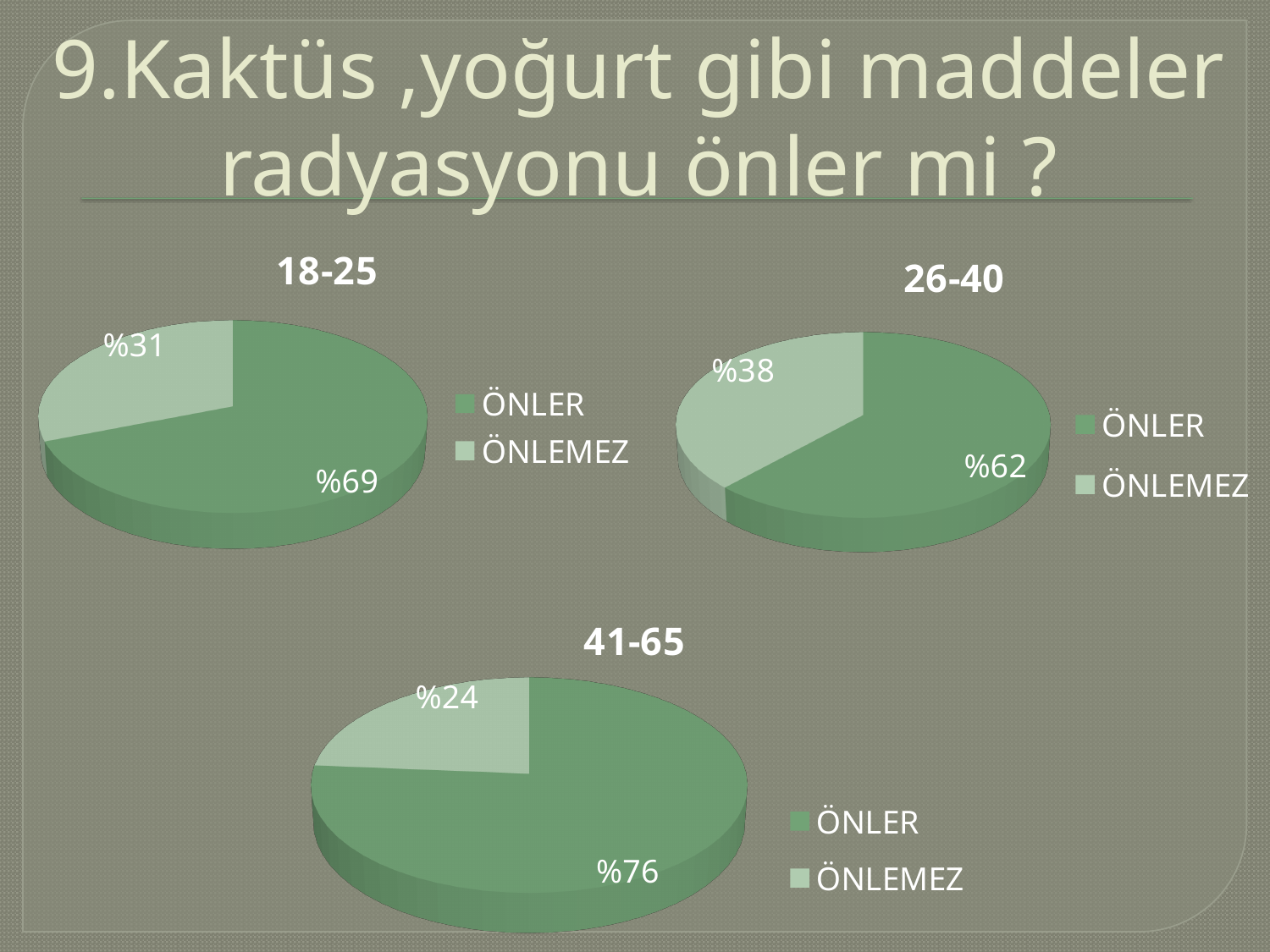
How many entries does the legend of the "18-25" chart list? 2 In the "41-65" pie chart, what is the value for ÖNLER? %76 In the "26-40" pie chart, what is the value for ÖNLER? %62 Which is larger: the ÖNLEMEZ value in the "26-40" chart or the ÖNLEMEZ value in the "41-65" chart? 26-40 In the "18-25" pie chart, what is the difference between the ÖNLER and ÖNLEMEZ values? %38 What kind of chart is the "41-65" chart? Pie chart In the "41-65" pie chart, which slice is the smallest? ÖNLEMEZ In the "41-65" pie chart, what is the value for ÖNLEMEZ? %24 In the "18-25" pie chart, what is the value for ÖNLEMEZ? %31 In the "26-40" pie chart, which slice is the largest? ÖNLER In the "26-40" pie chart, what is the value for ÖNLEMEZ? %38 In the "18-25" pie chart, what is the value for ÖNLER? %69